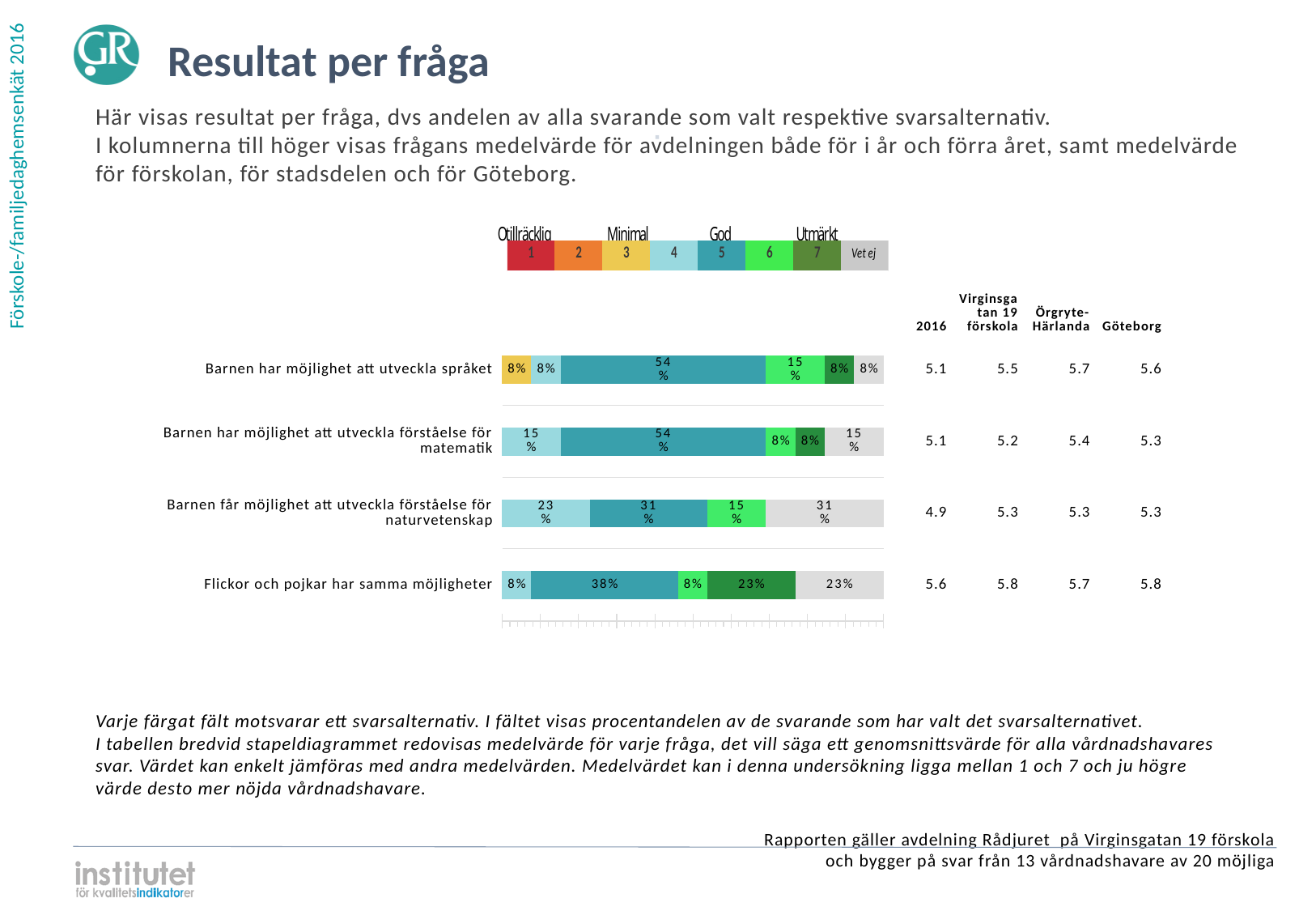
How many response categories does the legend show, including "Vet ej"? 8 What is the difference in percentage points between the option 5 share for "Barnen har möjlighet att utveckla språket" (54%) and for "Flickor och pojkar har samma möjligheter" (38%)? 16 percentage points Which has a larger option 7 (Utmärkt) share: "Flickor och pojkar har samma möjligheter" or "Barnen har möjlighet att utveckla språket"? Flickor och pojkar har samma möjligheter What percentage chose option 4 for "Barnen har möjlighet att utveckla förståelse för matematik"? 15% What percentage chose option 7 (Utmärkt) for "Flickor och pojkar har samma möjligheter"? 23% Which question has the largest "Vet ej" share? Barnen får möjlighet att utveckla förståelse för naturvetenskap Which response option is labelled "Utmärkt" in the legend? 7 What type of chart is used to show the results per question? Stacked bar chart What percentage of respondents chose option 5 (God) for "Barnen har möjlighet att utveckla språket"? 54% How many questions (bars) are shown in the chart? 4 Which question has the smallest share for option 5 (God)? Barnen får möjlighet att utveckla förståelse för naturvetenskap What percentage chose "Vet ej" for "Barnen får möjlighet att utveckla förståelse för naturvetenskap"? 31%